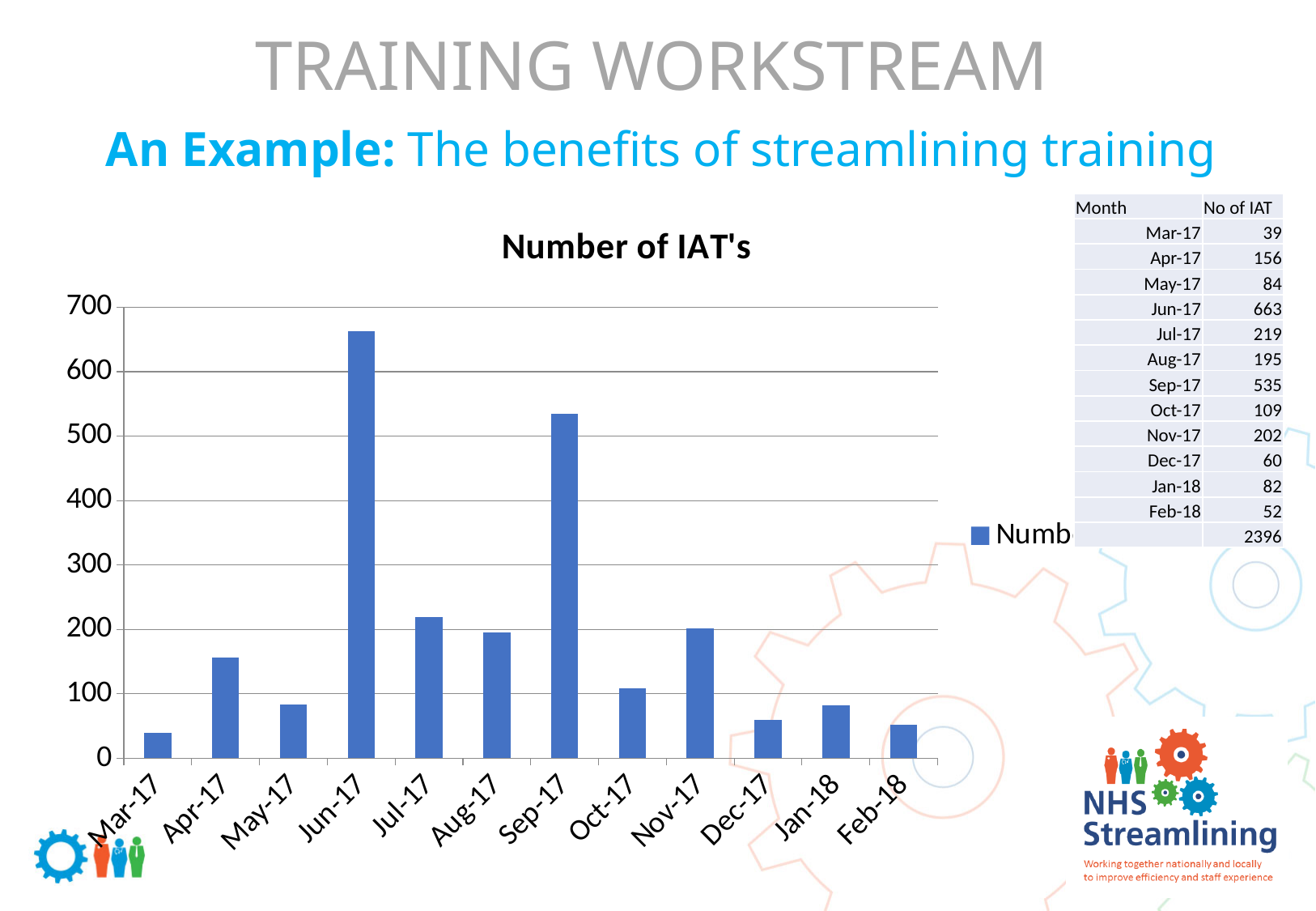
Which month has more IAT's, Apr-17 or Nov-17? Nov-17 Which month has the highest number of IAT's? Jun-17 What is the number of IAT's for Jun-17? 663 What is the title of the chart? Number of IAT's What is the number of IAT's for Feb-18? 52 Is the value for Oct-17 greater or less than 200? less How many months are plotted on the chart? 12 What is the number of IAT's for Sep-17? 535 Which month has the lowest number of IAT's? Mar-17 Is the value for Jul-17 greater or less than 200? greater What kind of chart is shown on the slide? bar chart What is the difference between the number of IAT's in Jun-17 and Sep-17? 128